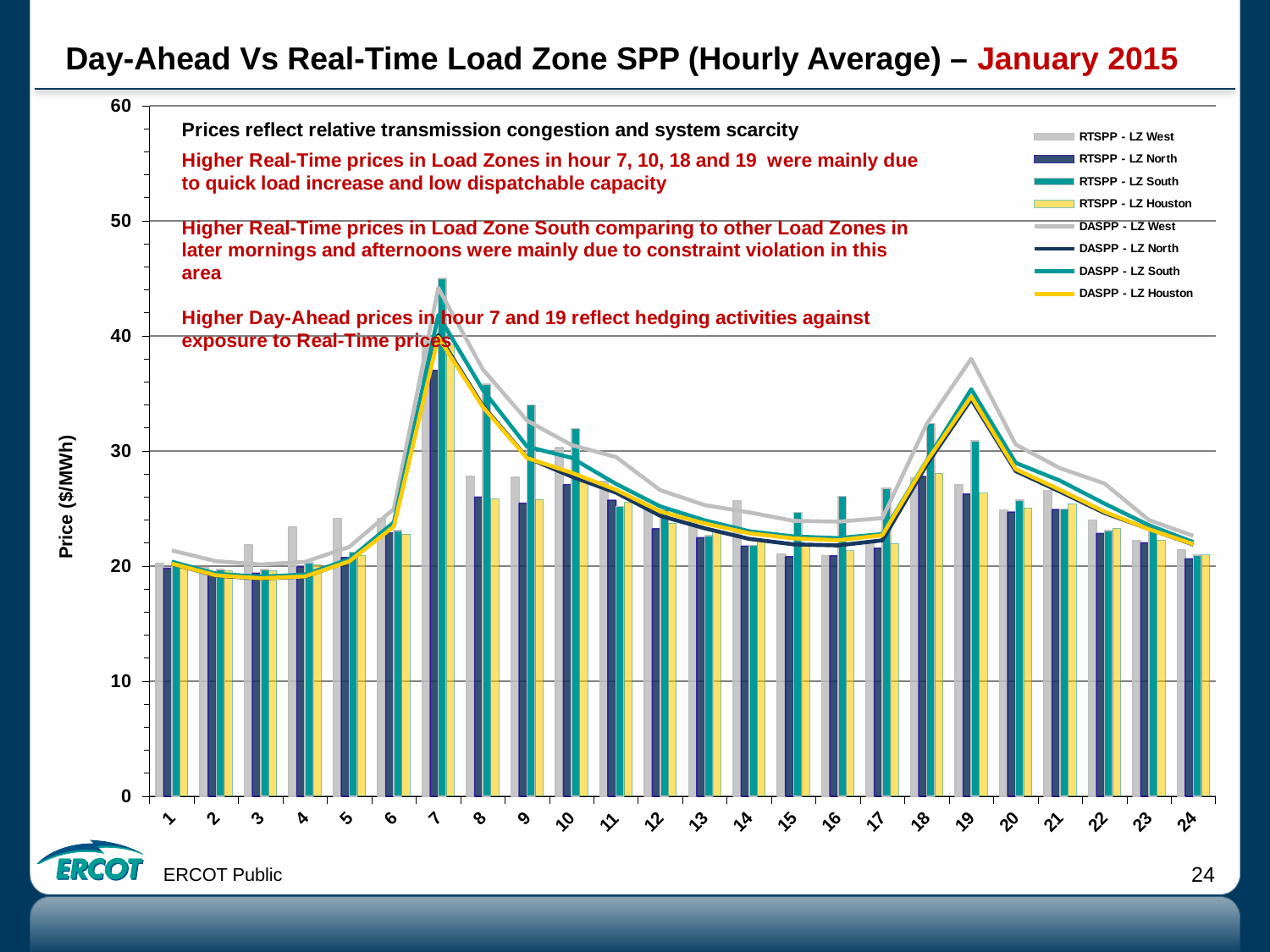
At which hour is the RTSPP - LZ South bar highest? 7 At which hour does the DASPP - LZ West line reach its peak? 7 Is the RTSPP - LZ South value at hour 7 greater or less than 40? greater Is the RTSPP - LZ North value at hour 1 greater or less than 30? less Do the DASPP lines rise or fall from hour 7 to hour 16? Fall How many series does the legend list? 8 How many hours are shown along the x axis? 24 What is the label on the y axis? Price ($/MWh) Is the RTSPP - LZ West value at hour 19 greater or less than 30? less Is the RTSPP - LZ South bar larger at hour 7 or at hour 19? Hour 7 What kind of chart is this? Combined bar and line chart Which is larger at hour 8: the RTSPP - LZ South bar or the RTSPP - LZ North bar? RTSPP - LZ South